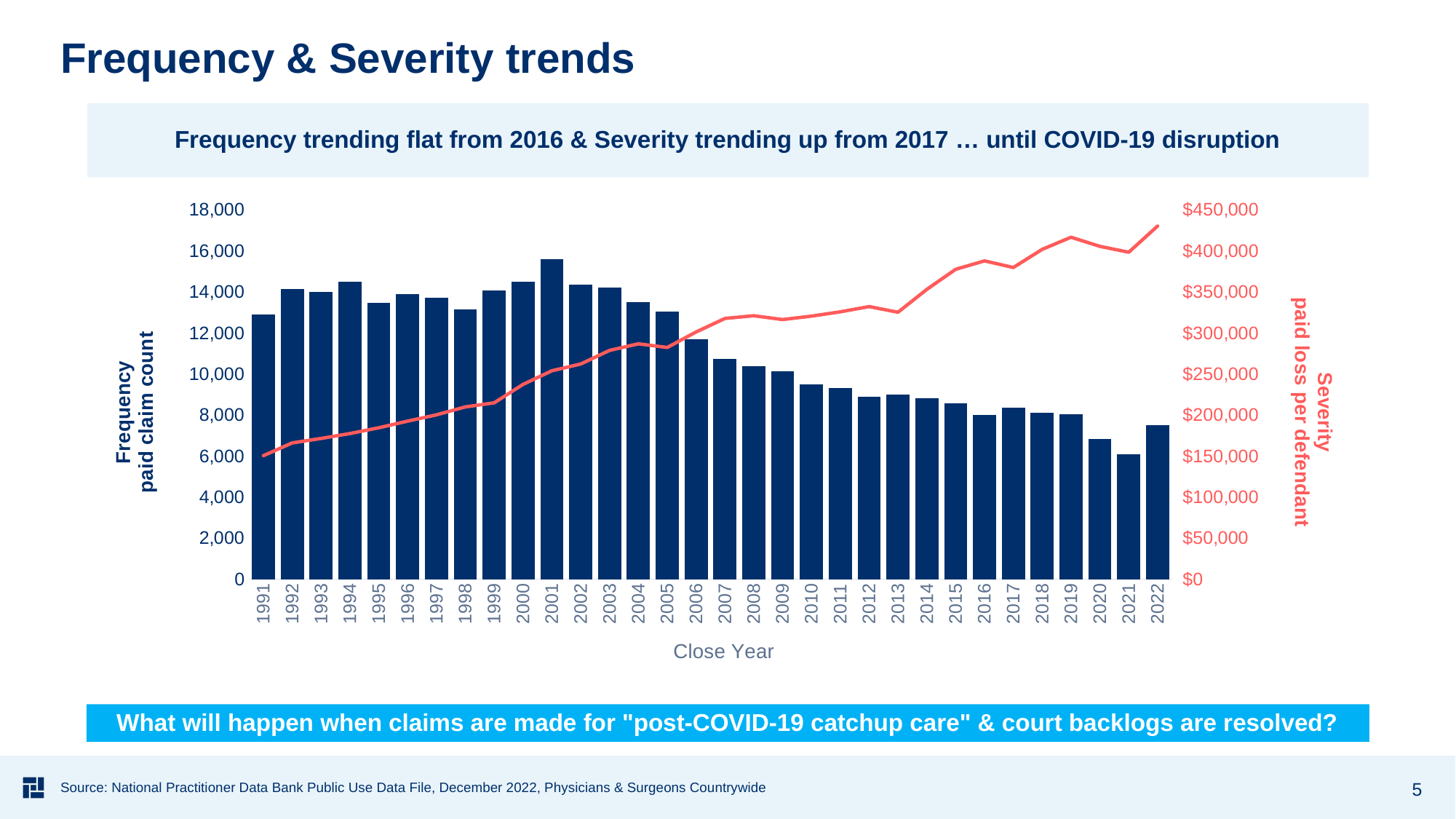
Which year has the larger frequency bar, 2022 or 2021? 2022 Is the frequency bar for 2021 greater or less than 8,000? less Do the frequency bars generally rise or fall from 2001 to 2021? fall Which year has the lowest frequency (paid claim count) bar? 2021 What kind of chart is shown on the slide? A combination bar and line chart Which year has the lowest severity (paid loss per defendant) on the line? 1991 Which year has the highest severity (paid loss per defendant) on the line? 2022 Is the frequency bar for 2001 greater or less than 14,000? greater Is the severity value for 2019 greater or less than $400,000? greater How many years are shown on the x axis of the chart? 32 What is the title of the x axis of the chart? Close Year Which year has the highest frequency (paid claim count) bar? 2001